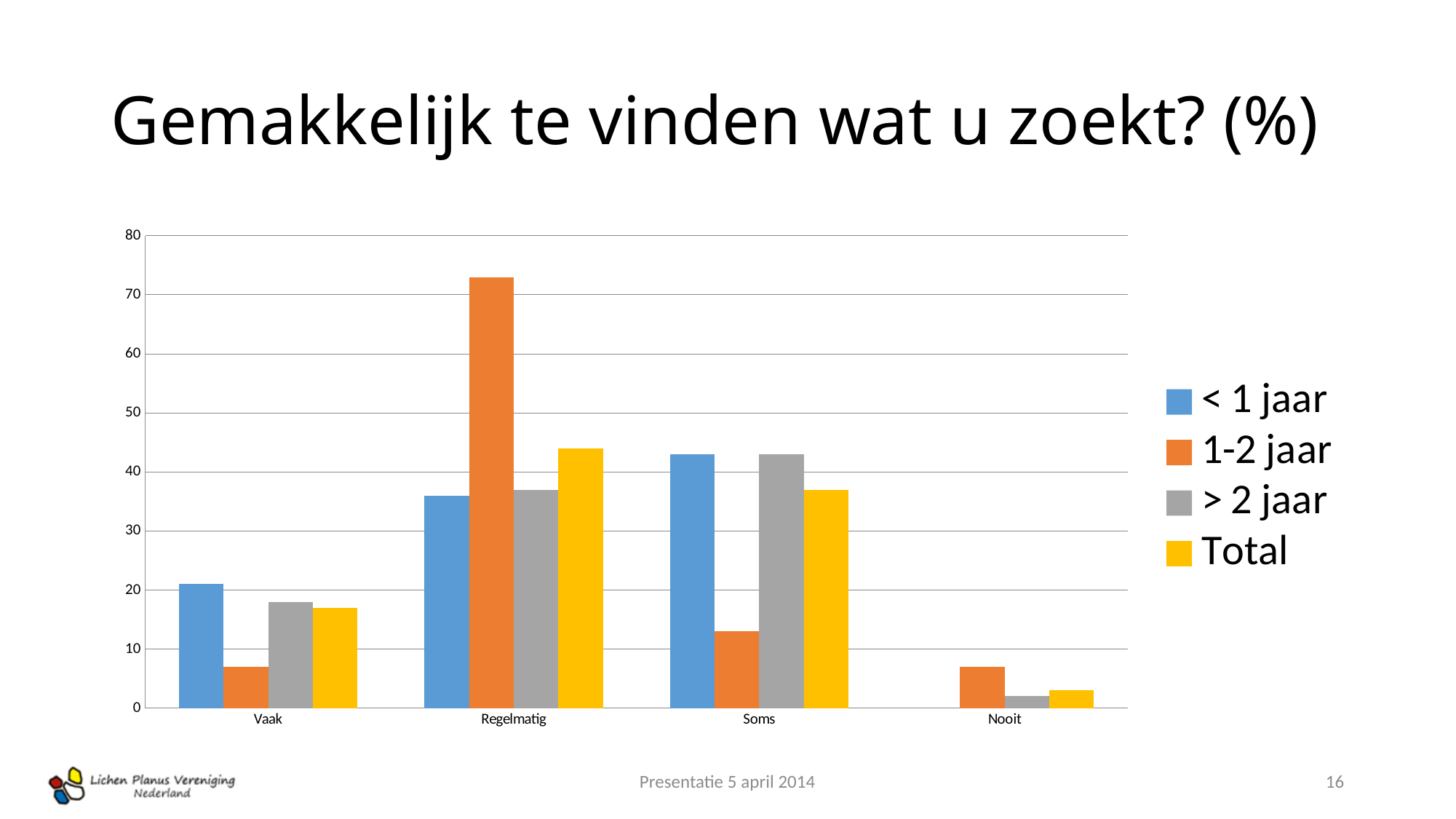
What kind of chart is shown on the slide? bar chart What is the title of the chart on the slide? Gemakkelijk te vinden wat u zoekt? (%) Which series has the highest bar in the Nooit category? 1-2 jaar Which series has the lowest bar in the Soms category? 1-2 jaar How many series does the chart's legend list? 4 Which series is shown in orange in the chart's legend? 1-2 jaar Is the value for 1-2 jaar in the Soms category greater or less than 20? less Which series has the highest bar in the Regelmatig category? 1-2 jaar Is the value for 1-2 jaar in the Regelmatig category greater or less than 70? greater How many categories are shown on the x axis of the chart? 4 Is the value for Total in the Regelmatig category greater or less than 40? greater For the Total series, which category has the larger value: Regelmatig or Soms? Regelmatig